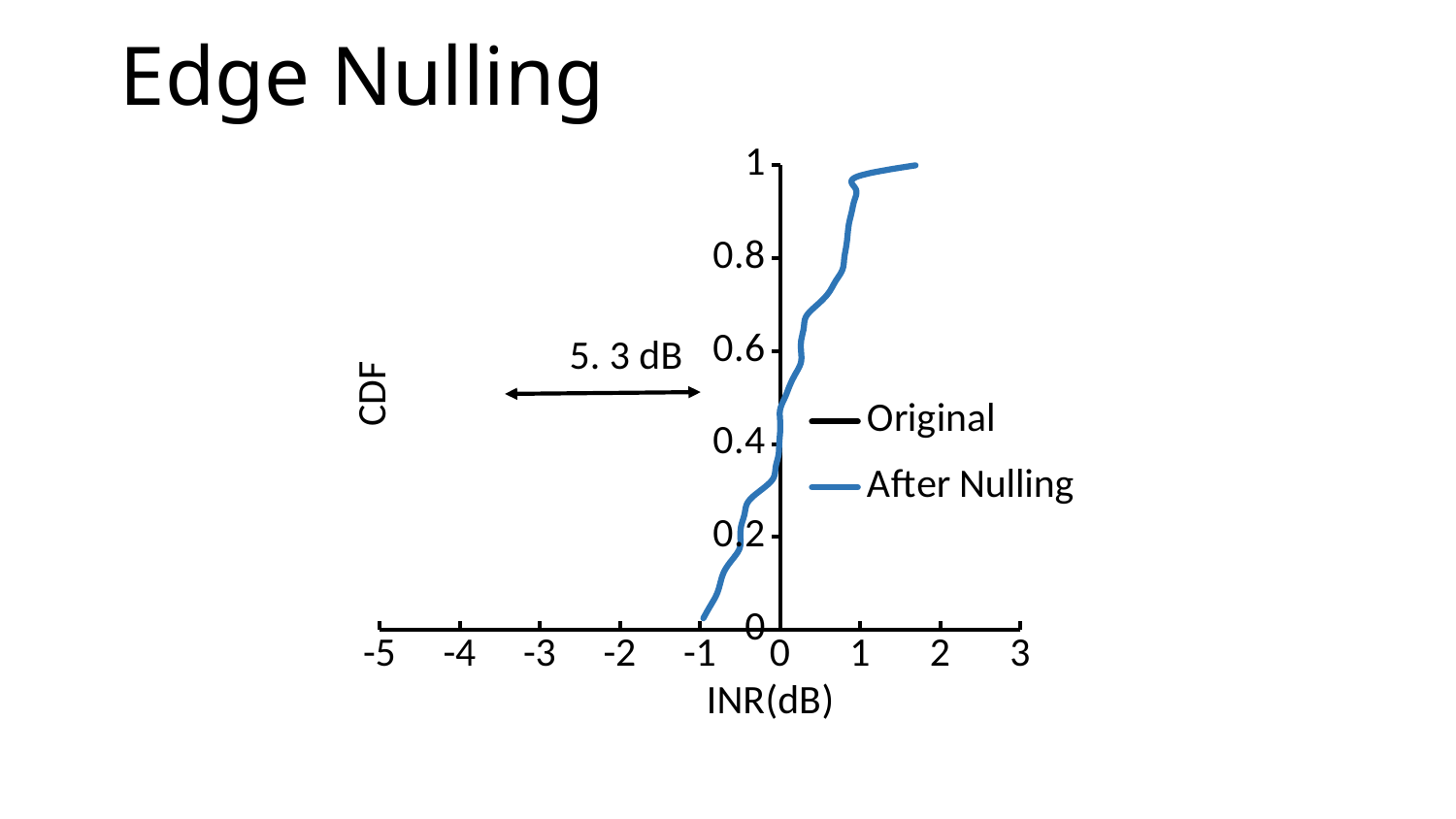
Is the CDF value of the After Nulling curve at INR = -1 dB greater or less than 0.2? less Does the After Nulling curve rise or fall as INR increases along the x axis? rise Is the CDF value of the After Nulling curve at INR = 1 dB greater or less than 0.8? greater What is the highest value shown on the x axis? 3 What kind of chart is shown on the slide? line chart What colour is the After Nulling series in the legend? blue How many series does the legend list? 2 What is the lowest value shown on the x axis? -5 Is the CDF value of the After Nulling curve at INR = 0.5 dB greater or less than 0.6? greater What value is written next to the double-headed arrow annotation on the chart? 5. 3 dB How many tick labels are shown on the x axis? 9